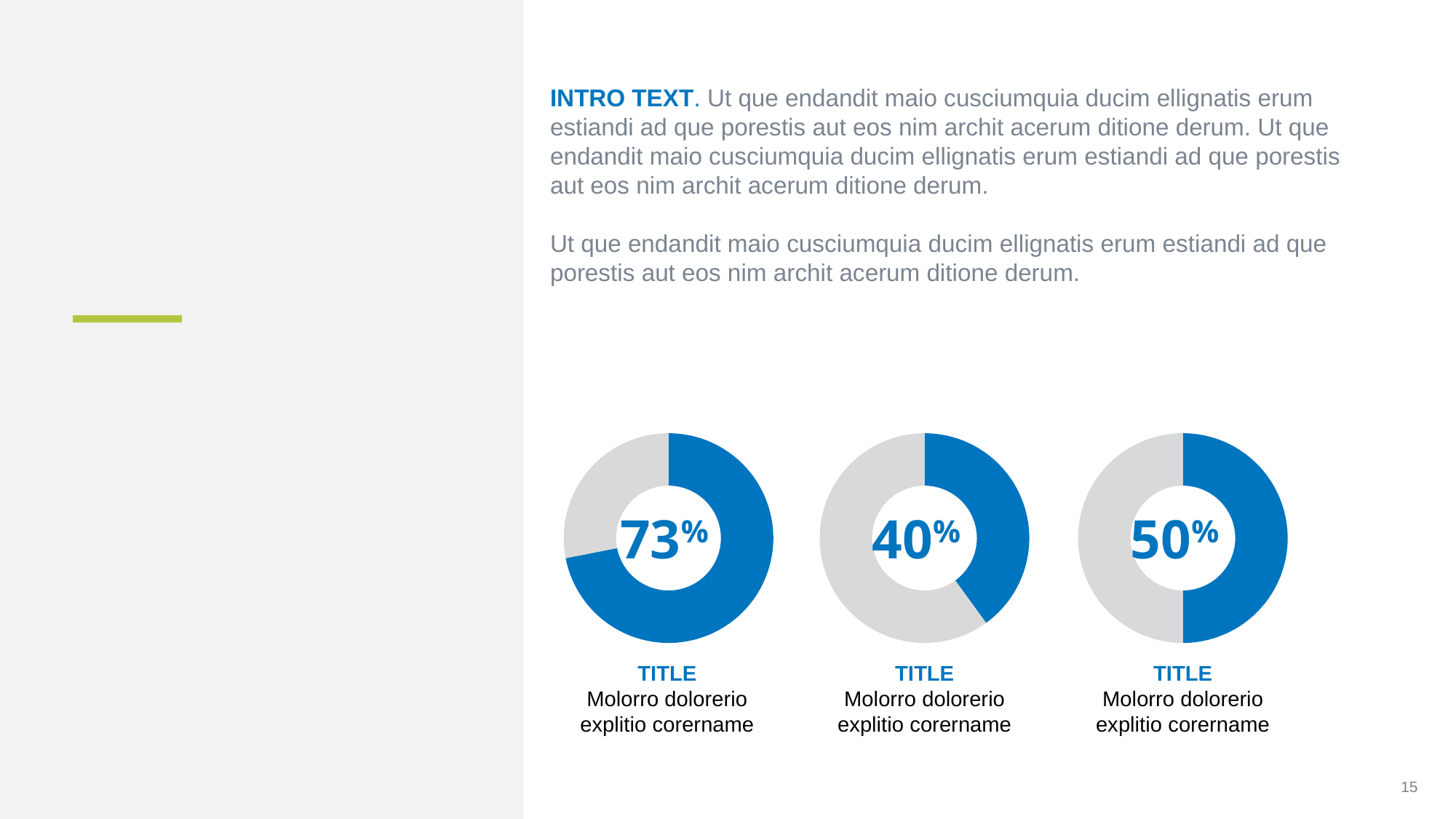
Which of the three donut charts shows the lowest percentage? The middle chart (40%) What percentage is shown in the centre of the middle donut chart? 40% What kind of chart is used to display the three percentages on the slide? Donut chart Which of the three donut charts shows the highest percentage? The left chart (73%) What colour is used for the filled portion of each donut chart? Blue What is the difference between the percentage in the left donut chart and the percentage in the middle donut chart? 33% What percentage is shown in the centre of the right donut chart? 50% What is the difference between the percentage in the right donut chart and the percentage in the middle donut chart? 10% What percentage is shown in the centre of the left donut chart? 73% What share of the right donut chart is filled in blue? 50% How many donut charts are shown on the slide? 3 Is the percentage in the left donut chart larger or smaller than the percentage in the right donut chart? Larger